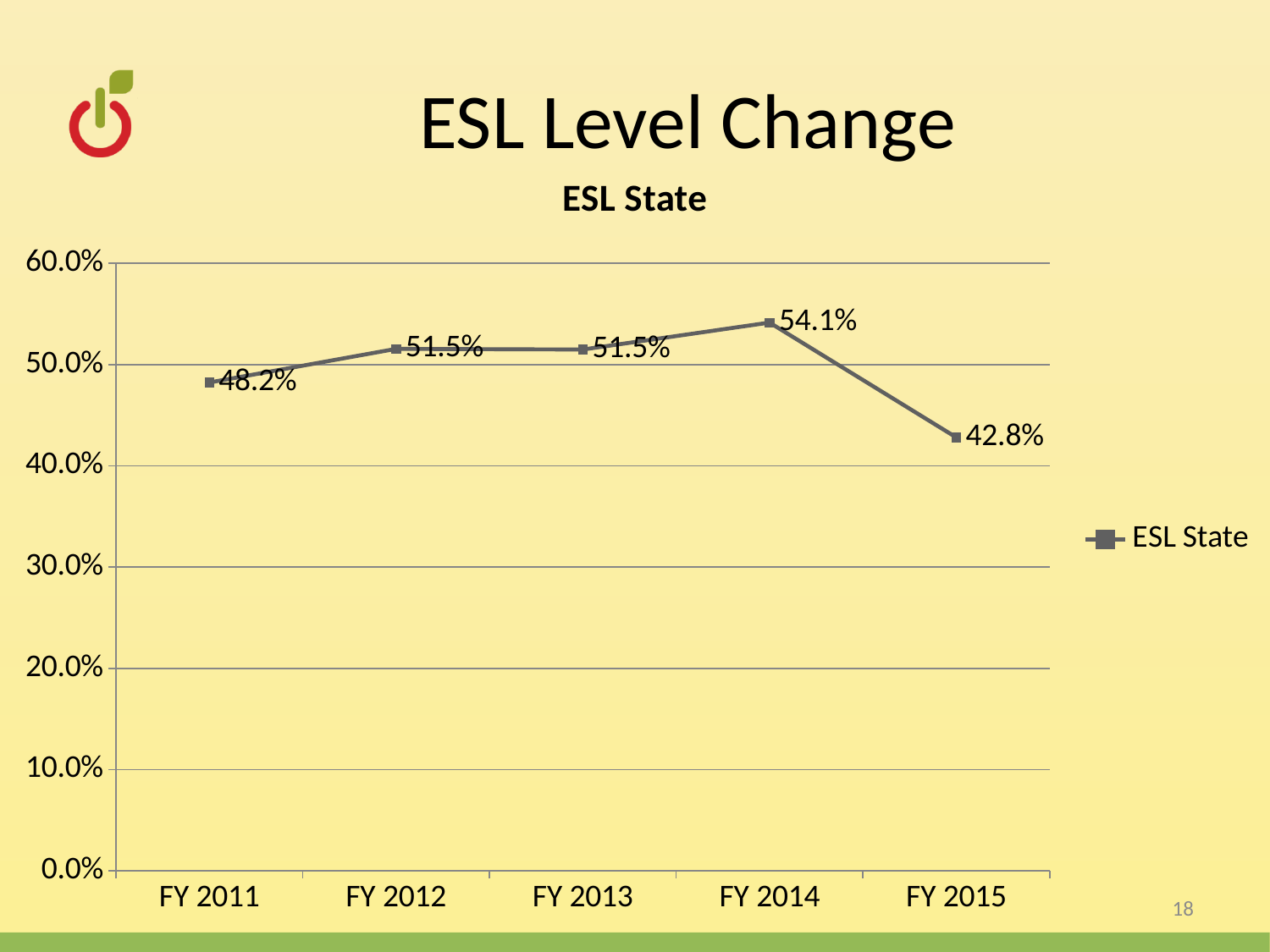
Which fiscal year has the lowest ESL State value? FY 2015 Is the ESL State value for FY 2015 greater or less than 50.0%? less What kind of chart is shown on the slide? line chart How many fiscal years are plotted on the chart? 5 What is the ESL State value for FY 2014? 54.1% Which fiscal year has the highest ESL State value? FY 2014 What is the ESL State value for FY 2011? 48.2% What is the difference between the ESL State values for FY 2014 and FY 2015? 11.3% How many series does the legend list? 1 What is the ESL State value for FY 2015? 42.8% Which is larger, the ESL State value for FY 2011 or FY 2012? FY 2012 What is the title of the chart? ESL State